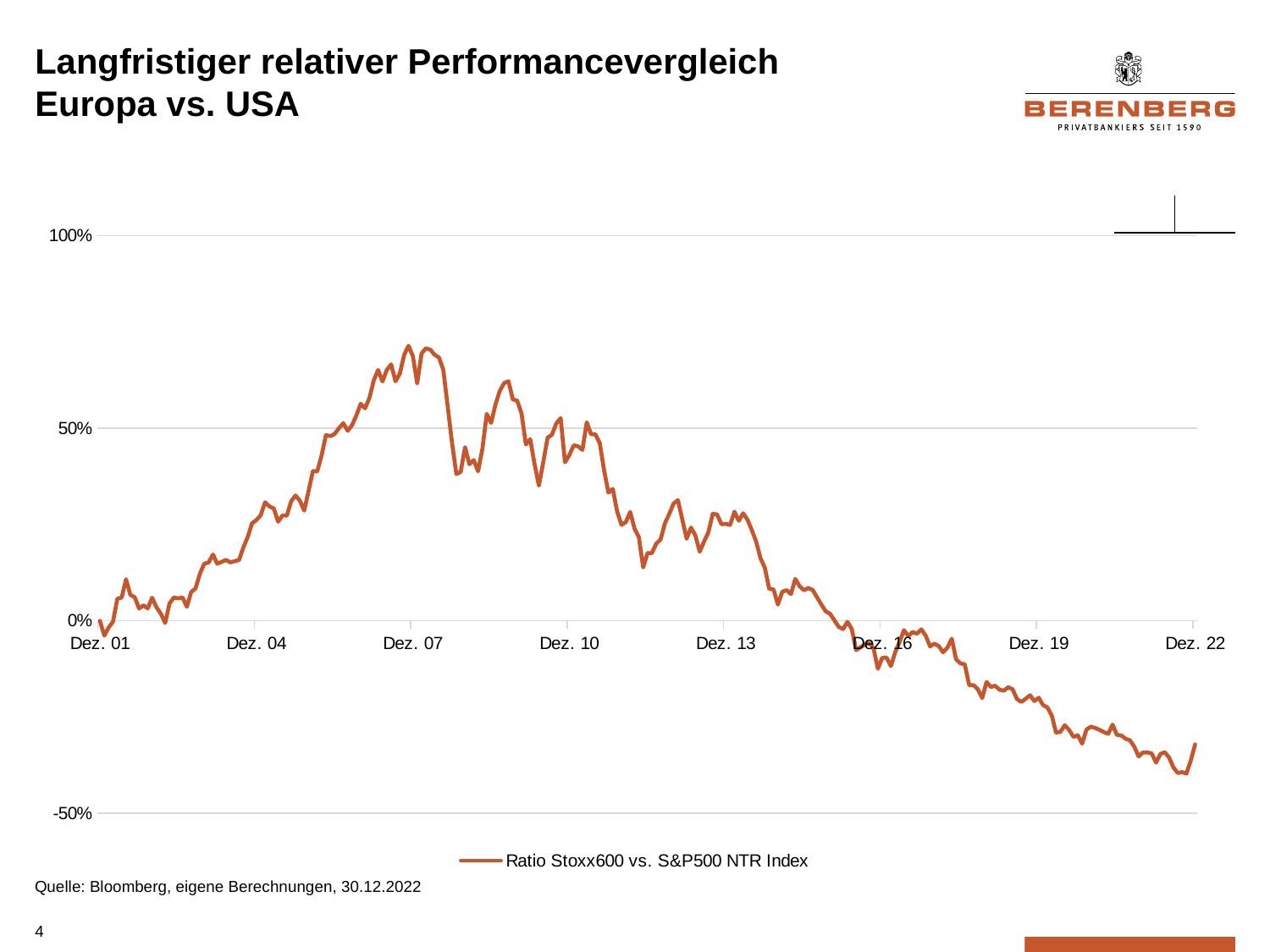
What is the name of the series shown in the legend? Ratio Stoxx600 vs. S&P500 NTR Index Is the value of the ratio at Dez. 22 greater or less than 0%? less Near which x-axis label does the line reach its highest value? Dez. 07 Does the line rise or fall between Dez. 01 and Dez. 07? rise Is the value of the ratio at Dez. 13 greater or less than 0%? greater Is the value of the ratio at Dez. 07 greater or less than 50%? greater Which is larger, the value of the ratio at Dez. 10 or at Dez. 19? Dez. 10 Does the line rise or fall between Dez. 07 and Dez. 22? fall How many labelled tick marks are on the x axis? 8 What kind of chart is shown on the slide? line chart How many series does the legend list? 1